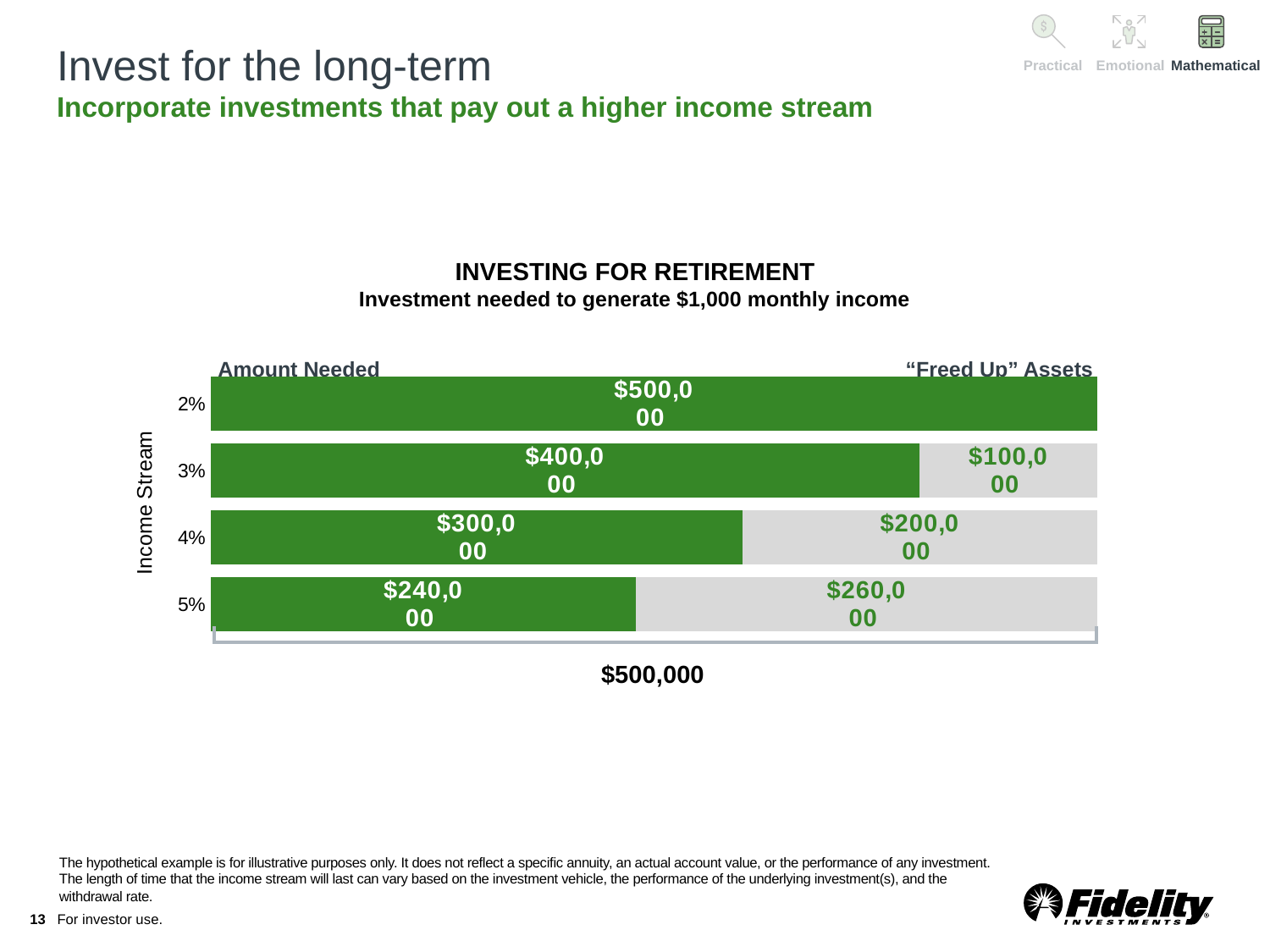
What is the Amount Needed for a 2% income stream? $500,000 Which is larger for the 5% income stream: Amount Needed or "Freed Up" Assets? "Freed Up" Assets Which income stream rate has the lowest Amount Needed? 5% What is the total of the stacked bar for the 4% income stream? $500,000 What kind of chart is shown on the slide? Stacked bar chart Which income stream rate has the highest Amount Needed? 2% What is the "Freed Up" Assets value for a 4% income stream? $200,000 What is the subtitle of the chart? Investment needed to generate $1,000 monthly income What is the Amount Needed for a 5% income stream? $240,000 What is the difference between the Amount Needed at 3% and at 4%? $100,000 How many income stream rates are shown on the chart? 4 What is the "Freed Up" Assets value for a 3% income stream? $100,000